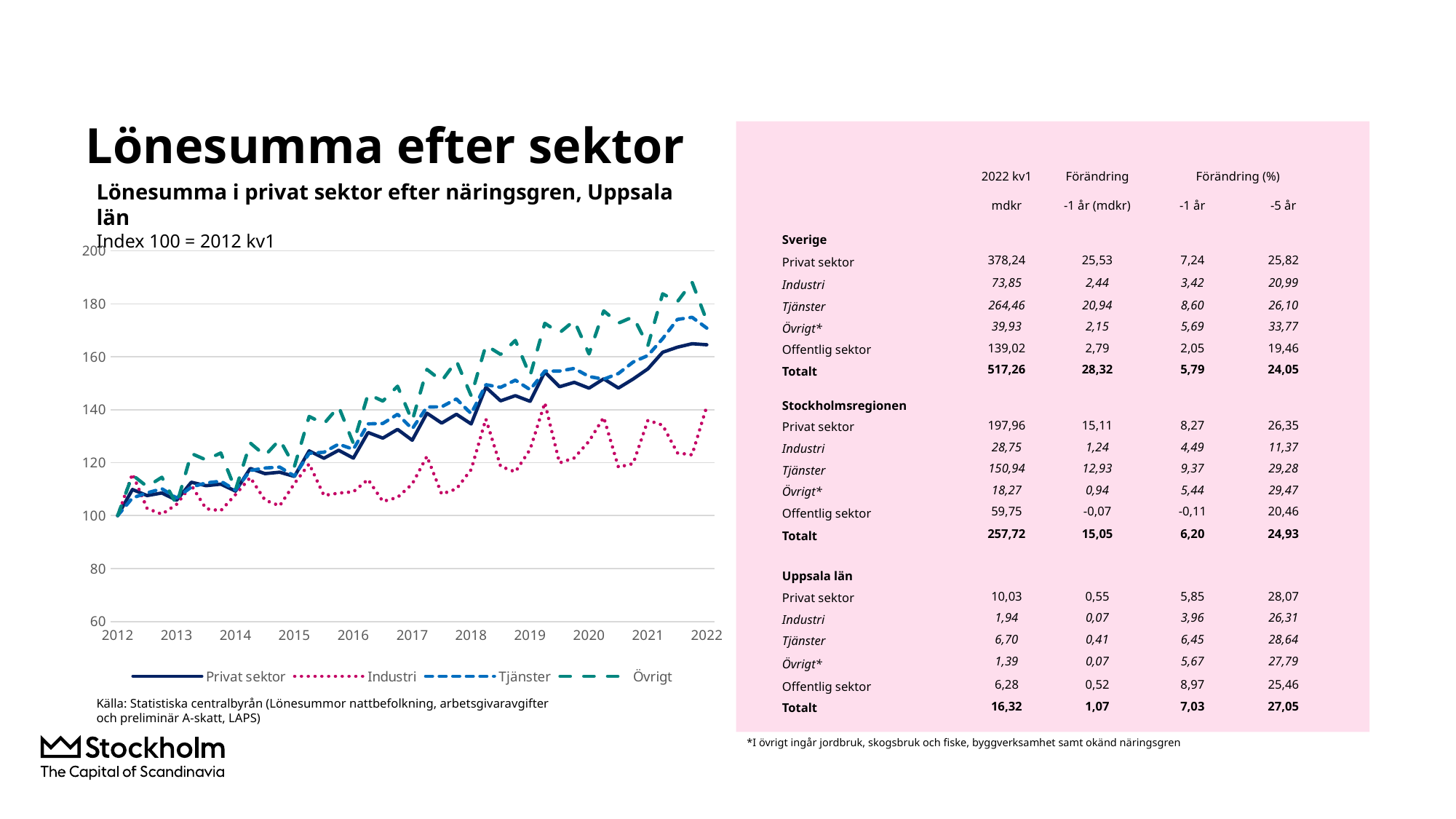
Is the value for Privat sektor in 2022 greater or less than 140? greater Does the Privat sektor series rise or fall from 2012 to 2022? rise Which series has the lowest value at the end of the chart in 2022? Industri Which series has the highest value at the end of the chart in 2022? Övrigt Is the value for Övrigt at the end of 2022 greater or less than 160? greater What is the index value of all series at the start of the chart in 2012? 100 How many series does the chart legend list? 4 What base period does the chart's index use (Index 100)? 2012 kv1 How many year labels are shown on the x axis of the chart? 11 What kind of chart is shown on the slide? line chart Is the value for Industri in 2022 greater or less than 160? less